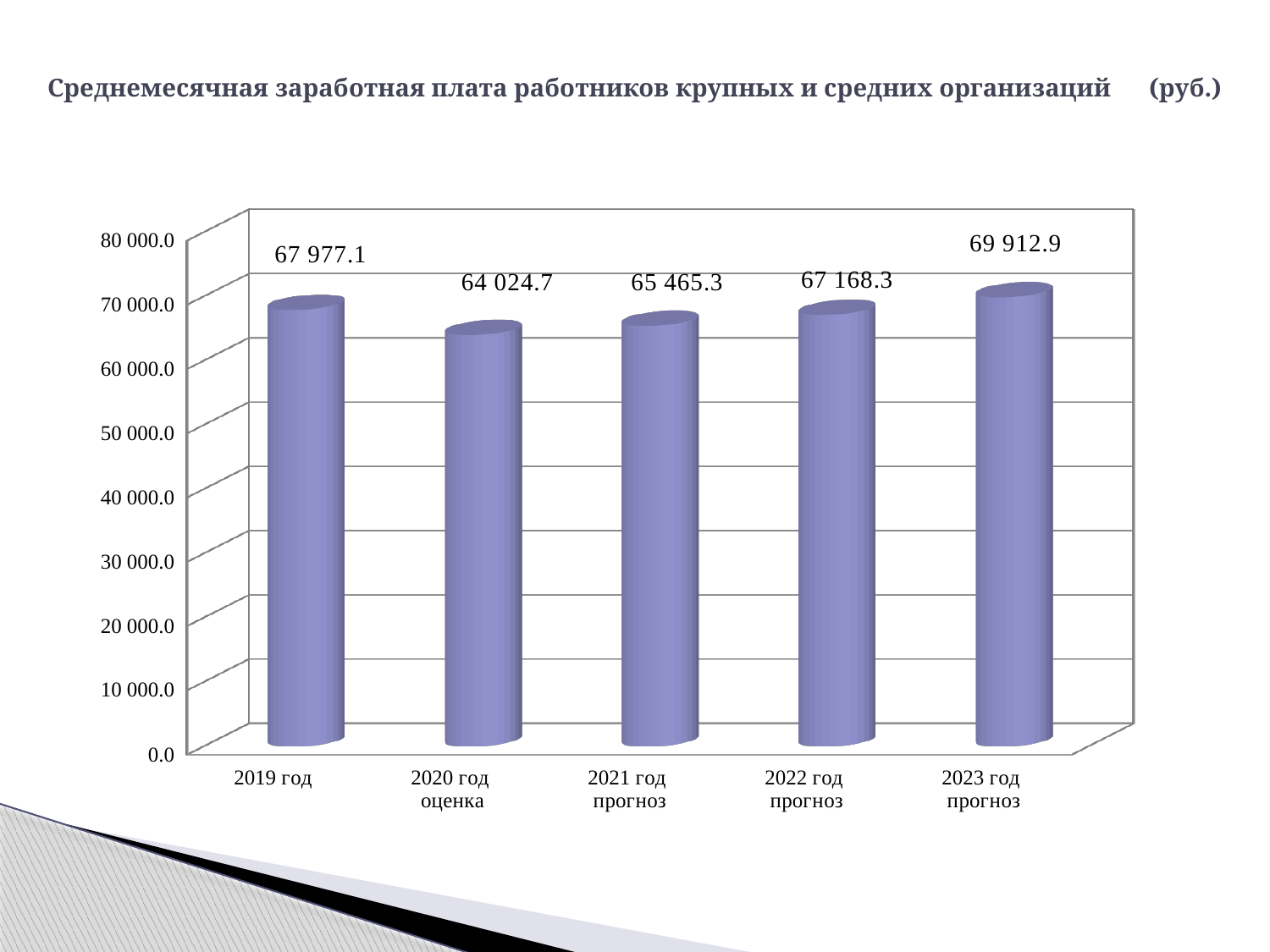
What is the value for 2019 год? 67 977.1 What is the difference between the values for 2019 год and 2020 год оценка? 3 952.4 Which is larger, the value for 2021 год прогноз or the value for 2022 год прогноз? 2022 год прогноз What kind of chart is shown on the slide? bar chart What is the value for 2023 год прогноз? 69 912.9 Which year has the highest value? 2023 год прогноз Which year has the lowest value? 2020 год оценка Do the values rise or fall from 2020 год оценка to 2023 год прогноз? rise What is the difference between the values for 2023 год прогноз and 2019 год? 1 935.8 How many years are shown on the chart? 5 What is the value for 2022 год прогноз? 67 168.3 What is the value for 2020 год оценка? 64 024.7